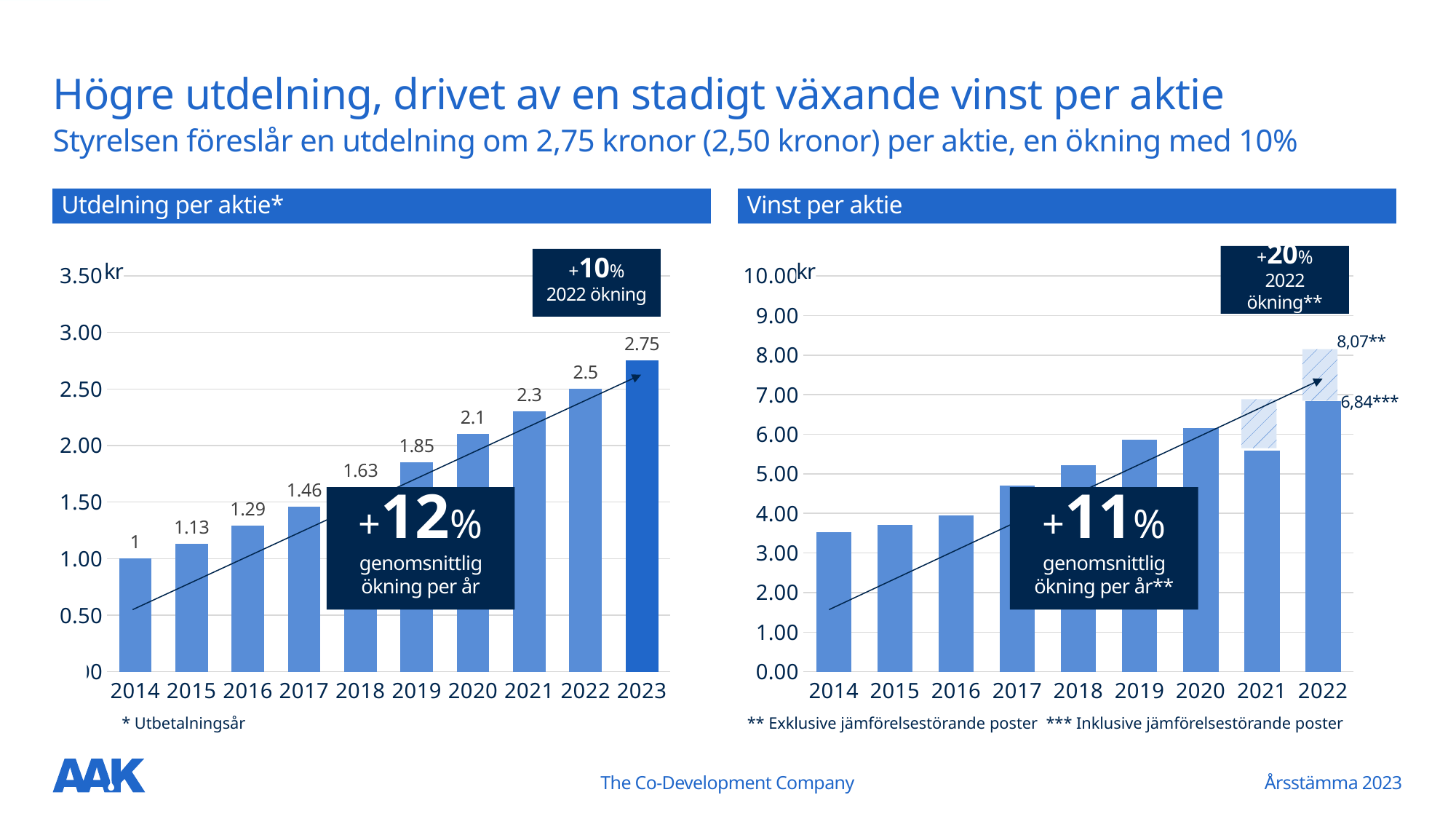
In the 'Vinst per aktie' chart, is the value for 2019 greater or less than 5.00? greater In the 'Utdelning per aktie*' chart, what is the difference between the values for 2023 and 2022? 0.25 In the 'Vinst per aktie' chart, what is the value labelled for 2022 excluding items affecting comparability (**)? 8,07 How many years are shown in the 'Utdelning per aktie*' chart? 10 In the 'Vinst per aktie' chart, is the value for 2014 greater or less than 4.00? less How many years are shown in the 'Vinst per aktie' chart? 9 In the 'Utdelning per aktie*' chart, do the values rise or fall from 2014 to 2023? rise In the 'Utdelning per aktie*' chart, which year has the highest value? 2023 In the 'Utdelning per aktie*' chart, which year has the lowest value? 2014 What kind of chart is the 'Vinst per aktie' chart? bar chart In the 'Utdelning per aktie*' chart, what is the value for 2019? 1.85 In the 'Utdelning per aktie*' chart, what is the value for 2023? 2.75